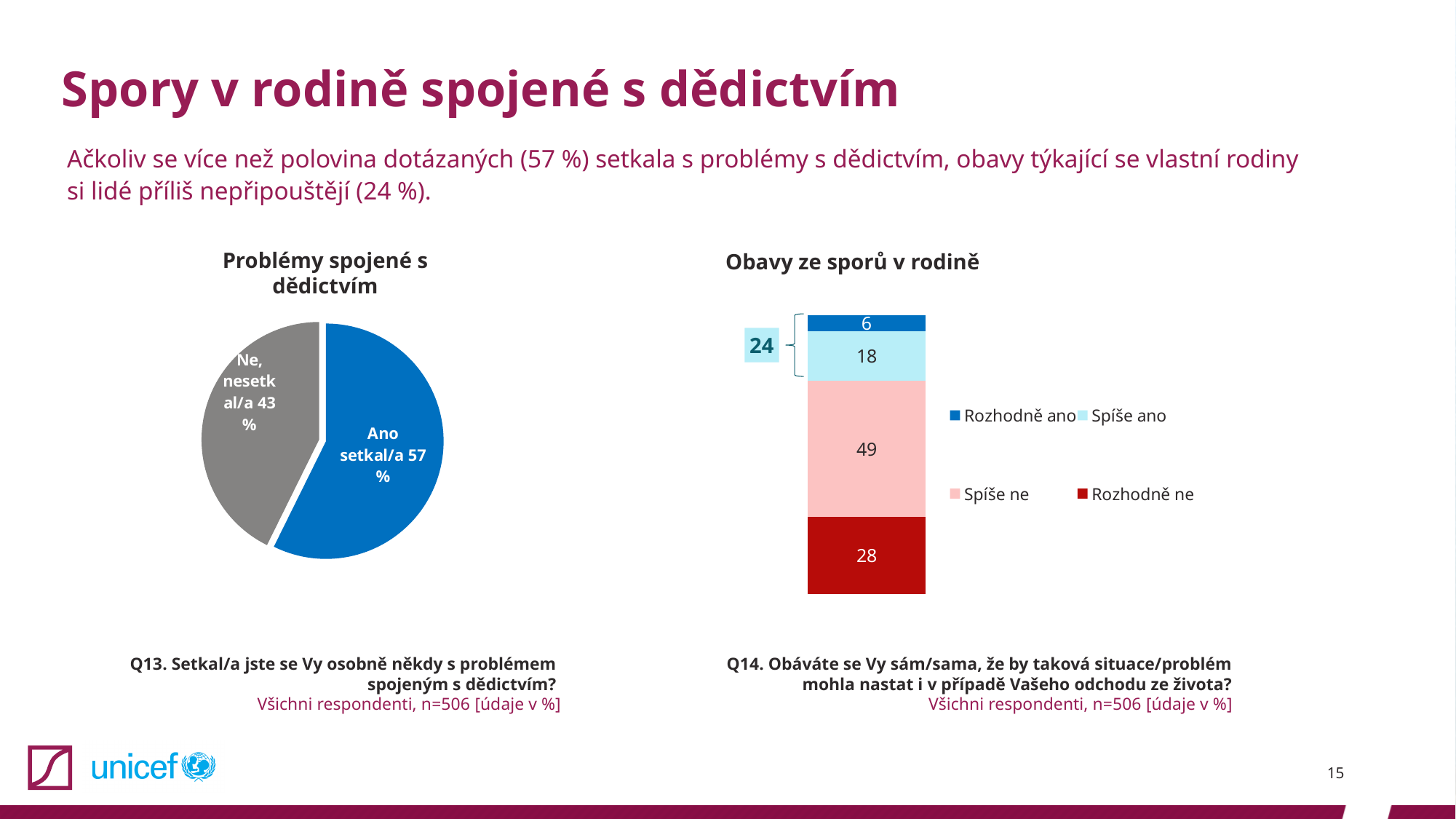
In the chart 'Obavy ze sporů v rodině', which category has the lowest value? Rozhodně ano In the chart 'Problémy spojené s dědictvím', what share of respondents answered 'Ne, nesetkal/a'? 43 % In the chart 'Problémy spojené s dědictvím', which slice is larger, 'Ano setkal/a' or 'Ne, nesetkal/a'? Ano setkal/a In the chart 'Obavy ze sporů v rodině', what is the combined value of 'Rozhodně ano' and 'Spíše ano' shown by the bracket? 24 In the chart 'Obavy ze sporů v rodině', what is the value for 'Rozhodně ne'? 28 In the chart 'Obavy ze sporů v rodině', which category has the highest value? Spíše ne In the chart 'Problémy spojené s dědictvím', what is the difference between the 'Ano setkal/a' and 'Ne, nesetkal/a' shares? 14 % In the chart 'Obavy ze sporů v rodině', what is the value for 'Spíše ne'? 49 In the chart 'Problémy spojené s dědictvím', what share of respondents answered 'Ano setkal/a'? 57 % In the chart 'Obavy ze sporů v rodině', what is the value for 'Rozhodně ano'? 6 How many series does the legend of the chart 'Obavy ze sporů v rodině' list? 4 What kind of chart is 'Problémy spojené s dědictvím'? Pie chart